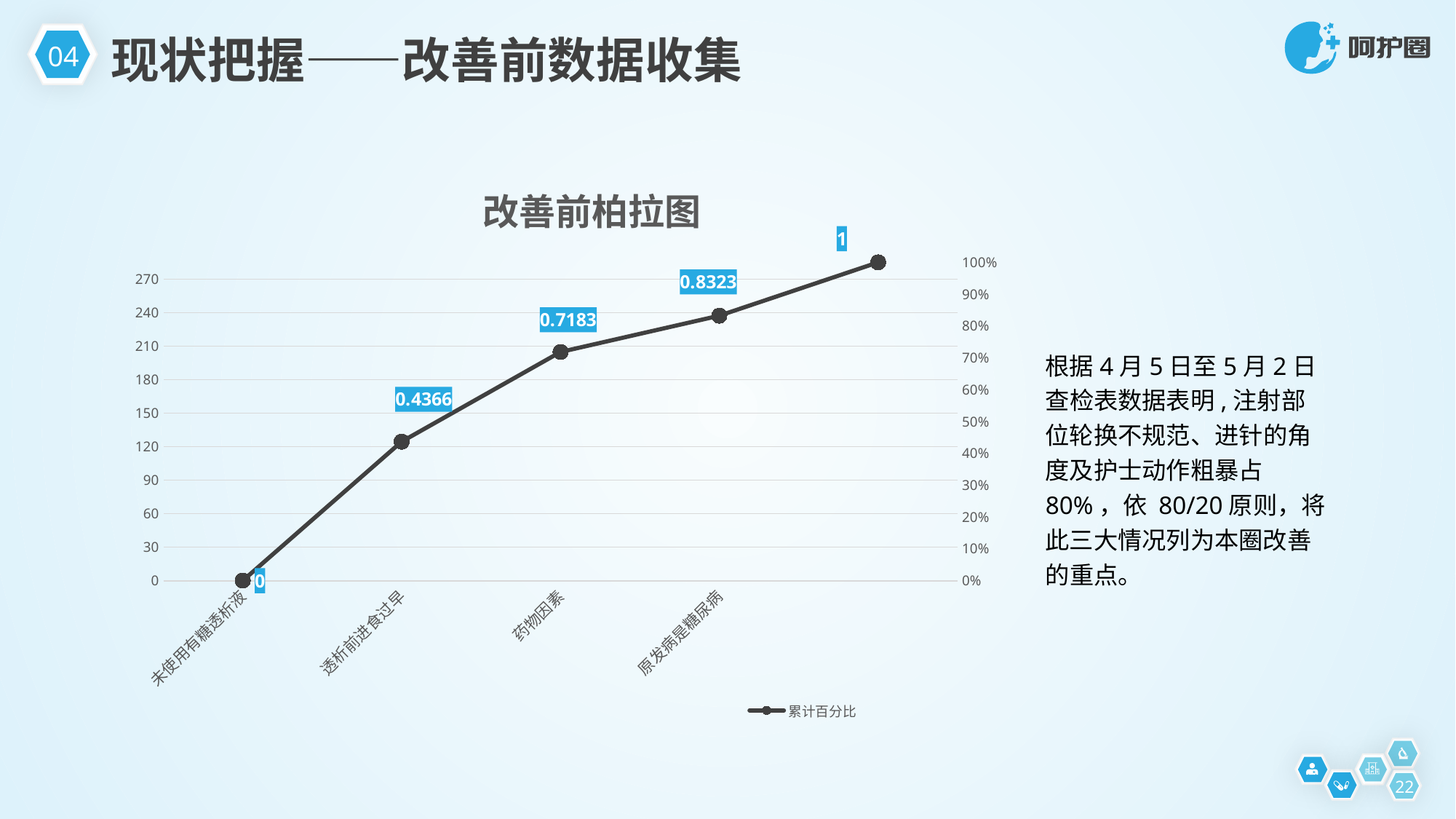
What is the difference between the labeled values for 药物因素 and 透析前进食过早? 0.2817 Do the plotted values rise or fall from left to right along the x axis? rise Which category has the lowest labeled value on the chart? 未使用有糖透析液 Which has the larger labeled value, 药物因素 or 透析前进食过早? 药物因素 What is the cumulative percentage value labeled for 药物因素? 0.7183 How many series does the legend list? 1 What is the title of the chart? 改善前柏拉图 What is the cumulative percentage value labeled for 未使用有糖透析液? 0 What is the cumulative percentage value labeled for 透析前进食过早? 0.4366 What is the difference between the labeled values for 原发病是糖尿病 and 药物因素? 0.114 What kind of chart is shown on the slide? line chart What is the cumulative percentage value labeled for 原发病是糖尿病? 0.8323